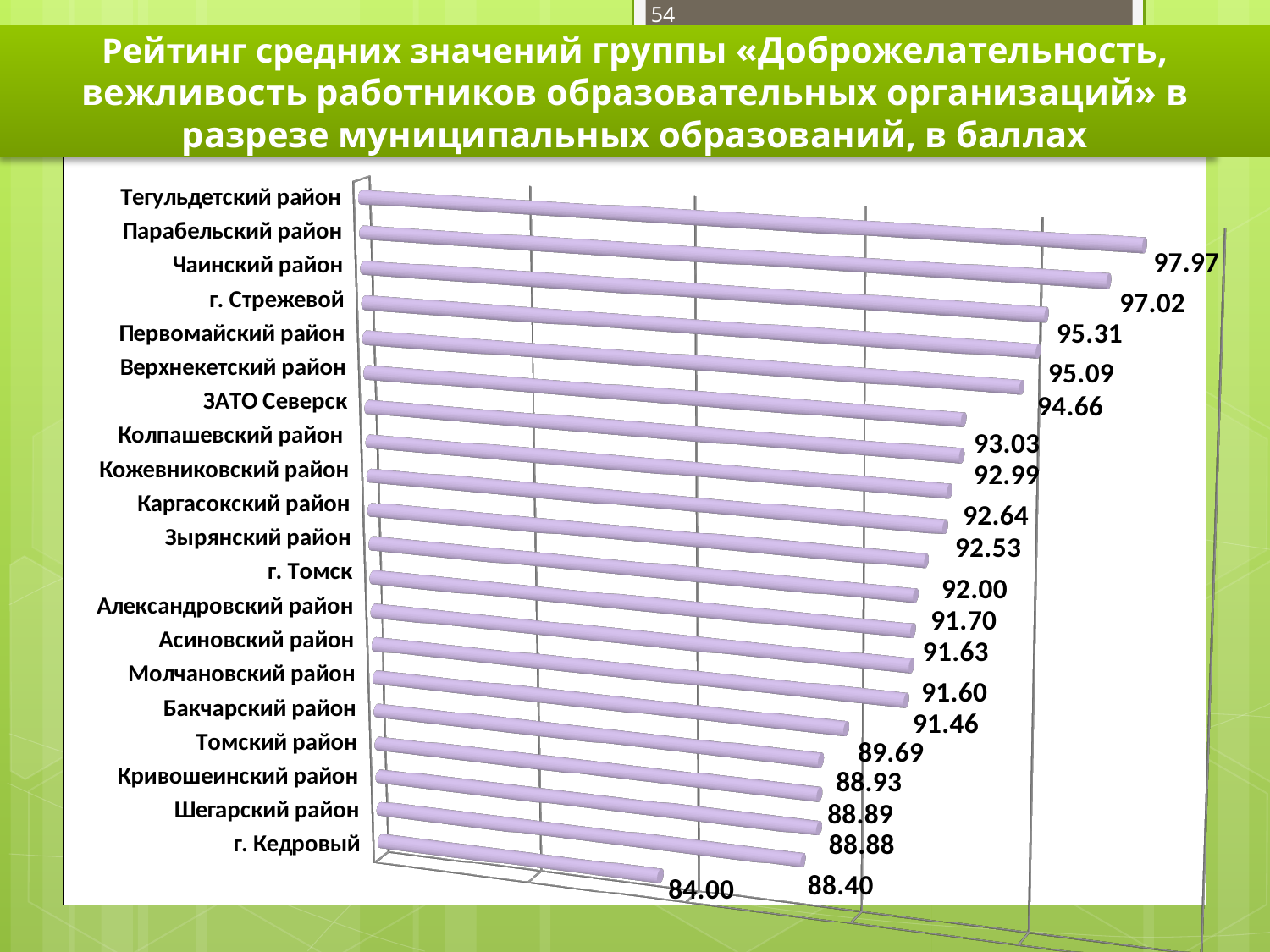
What is the value for ЗАТО Северск? 92.99 What is the difference between the values for Тегульдетский район and г. Кедровый? 13.97 Which municipality has the highest value? Тегульдетский район What is the difference between the values for Парабельский район and Чаинский район? 1.71 Which municipality has the lowest value? г. Кедровый What is the value for г. Томск? 91.63 What is the value for Тегульдетский район? 97.97 What is the value for г. Кедровый? 84.00 How many municipalities are shown in the chart? 20 Which is larger, the value for Первомайский район or the value for Молчановский район? Первомайский район Do the values increase or decrease going down the list of municipalities from top to bottom? Decrease What kind of chart is shown on the slide? Bar chart